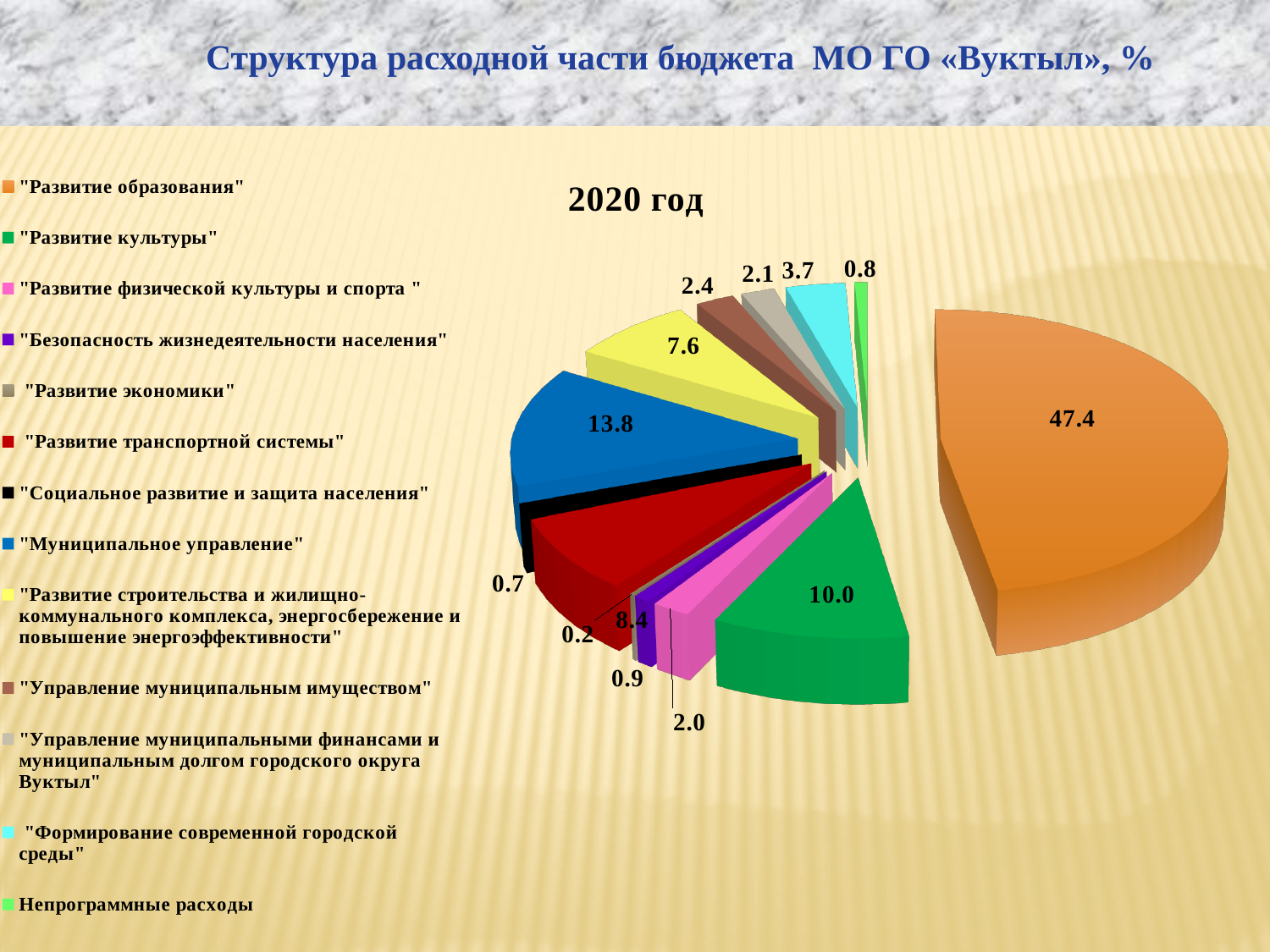
What type of chart is shown on the slide? pie chart Which category has the smallest share of the pie chart? "Развитие экономики" What is the value for "Развитие транспортной системы" in the pie chart? 8.4 Which is larger: the value for "Управление муниципальным имуществом" or the value for "Развитие физической культуры и спорта"? "Управление муниципальным имуществом" What is the title shown above the pie chart? 2020 год Which category has the largest share of the pie chart? "Развитие образования" What is the difference between the values for "Муниципальное управление" and "Развитие культуры"? 3.8 What is the value for "Развитие культуры" in the pie chart? 10.0 How many categories does the legend of the pie chart list? 13 What is the value for "Муниципальное управление" in the pie chart? 13.8 What is the value for "Формирование современной городской среды" in the pie chart? 3.7 What is the value for "Развитие образования" in the 2020 год pie chart? 47.4